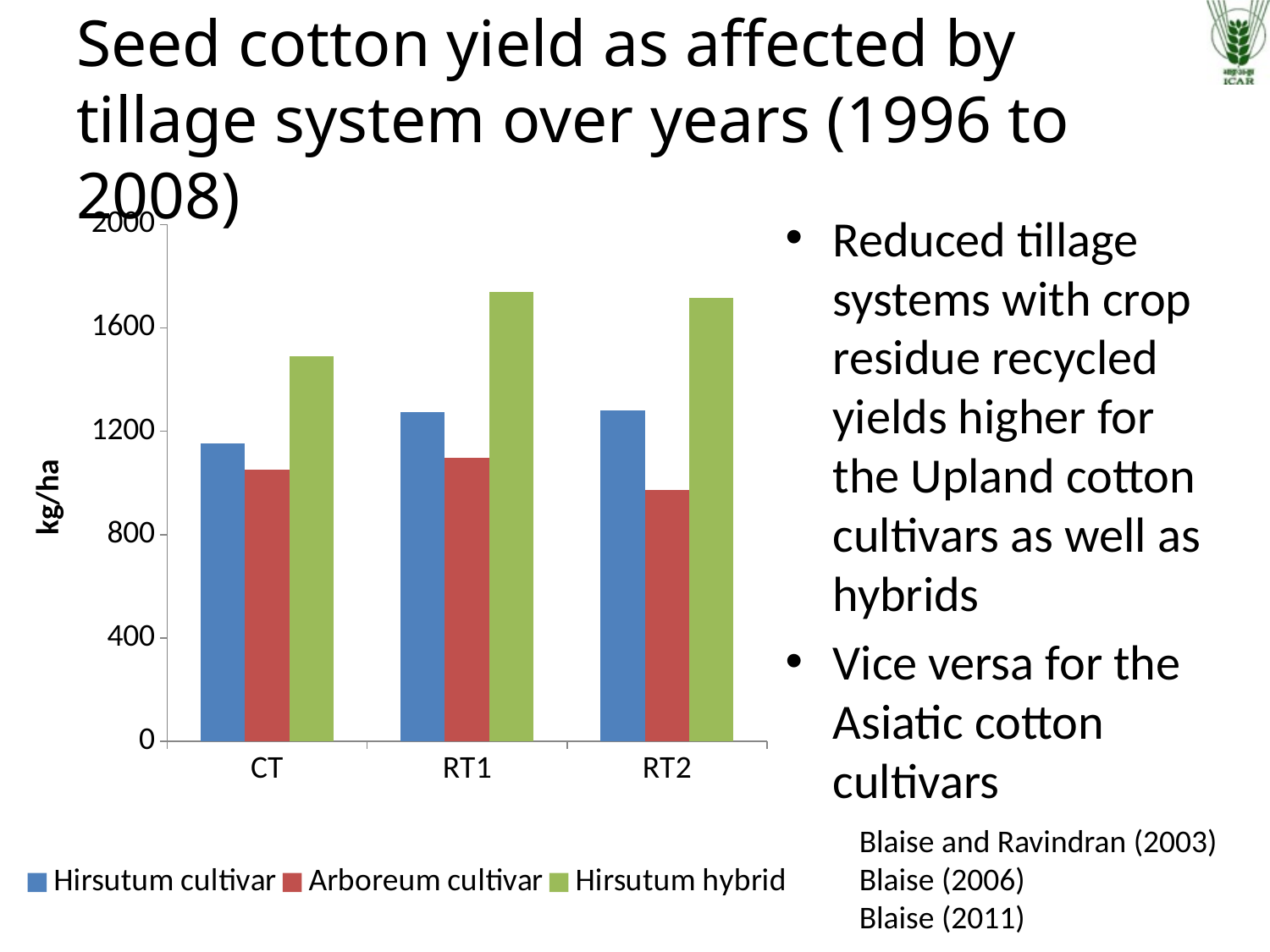
Which series has the lowest yield in the RT2 category? Arboreum cultivar How many tillage system categories are shown on the x axis? 3 Is the Arboreum cultivar yield for RT2 greater or less than 1200 kg/ha? less In which tillage category is the Hirsutum hybrid yield lowest? CT Is the Hirsutum hybrid yield for CT greater or less than 1600 kg/ha? less Is the Hirsutum hybrid yield for RT1 greater or less than 1600 kg/ha? greater Which series has the highest yield in the CT category? Hirsutum hybrid Which is larger, the Hirsutum hybrid yield for CT or for RT1? RT1 How many series does the legend list? 3 In which tillage category is the Arboreum cultivar yield lowest? RT2 What is the label on the y axis of the chart? kg/ha What kind of chart is shown on the slide? bar chart